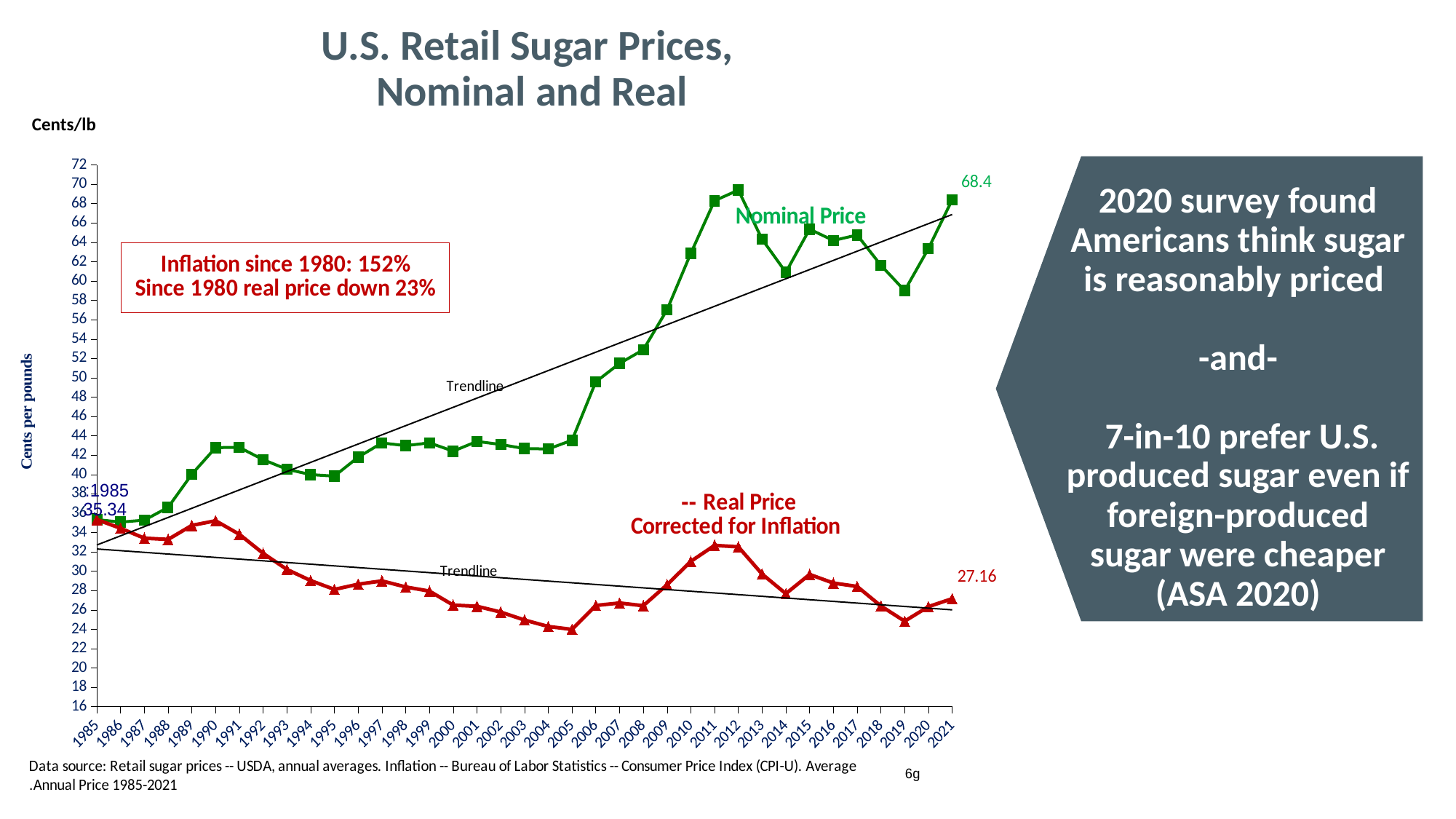
What kind of chart is shown on the slide? line chart Does the Real Price Corrected for Inflation generally rise or fall from 1985 to 2021? fall Is the Nominal Price in 2000 greater or less than 40? greater What is the Real Price Corrected for Inflation in 2021? 27.16 What is the difference between the Nominal Price and the Real Price in 2021? 41.24 What unit is shown for the y axis of the chart? Cents/lb What is the Nominal Price in 2021? 68.4 In 2021, which is larger: the Nominal Price or the Real Price Corrected for Inflation? Nominal Price Is the Real Price Corrected for Inflation in 2005 greater or less than 26? less Is the Nominal Price in 2012 greater or less than 60? greater Does the Nominal Price generally rise or fall from 1985 to 2021? rise What is the labelled price value at the start of the series in 1985? 35.34